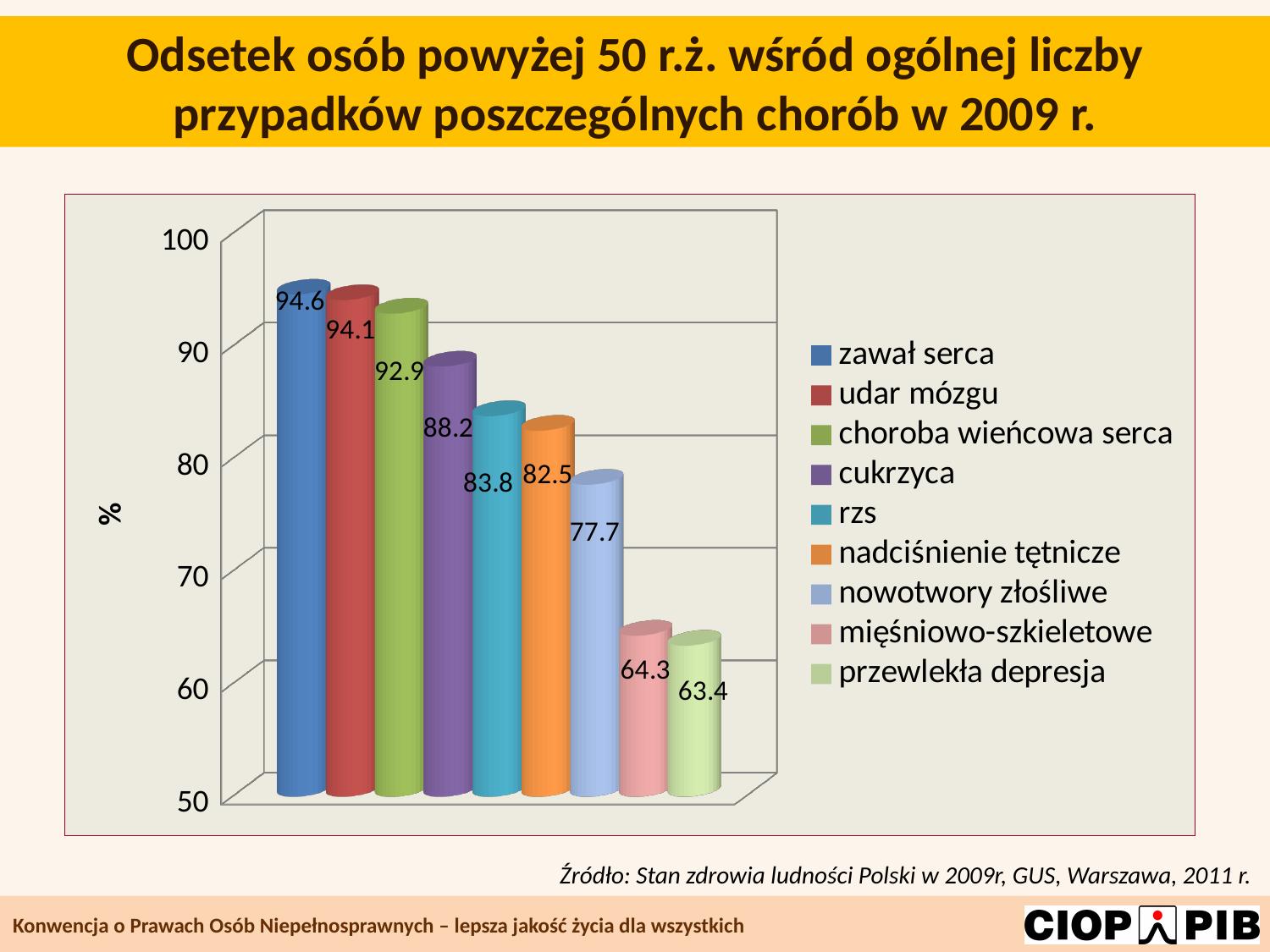
Which is larger, the value for udar mózgu or the value for choroba wieńcowa serca? udar mózgu What is the value for zawał serca? 94.6 Which category has the lowest value? przewlekła depresja How many bars are shown in the chart? 9 What kind of chart is shown on the slide? bar chart Which category has the highest value? zawał serca What is the value for nowotwory złośliwe? 77.7 What is the difference between the values for zawał serca and przewlekła depresja? 31.2 What is the value for przewlekła depresja? 63.4 How many entries does the legend list? 9 What is the difference between the values for rzs and nadciśnienie tętnicze? 1.3 What is the value for cukrzyca? 88.2